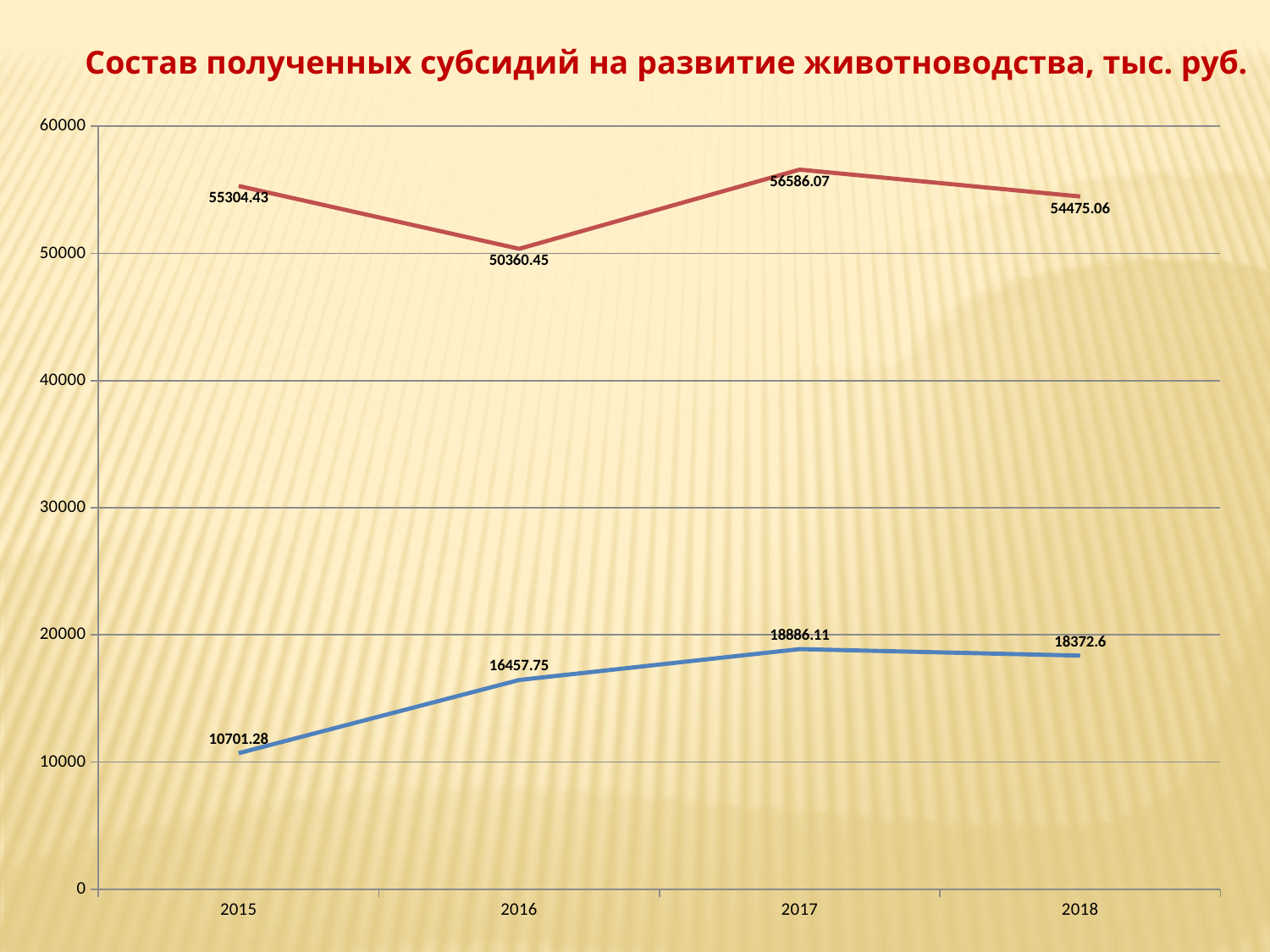
By how much did the blue line increase from 2015 to 2016? 5756.47 Is the blue line's value for 2017 greater or less than 20000? less What is the value of the red line for 2017? 56586.07 What is the difference between the red line's values for 2017 and 2016? 6225.62 In which year does the red line reach its highest value? 2017 What is the value of the blue line for 2015? 10701.28 What is the value of the red line for 2016? 50360.45 What type of chart is shown on the slide? line chart In which year does the blue line have its lowest value? 2015 Which is larger: the red line's value for 2015 or its value for 2018? 2015 (55304.43) What is the value of the blue line for 2018? 18372.6 How many years are shown on the x axis? 4